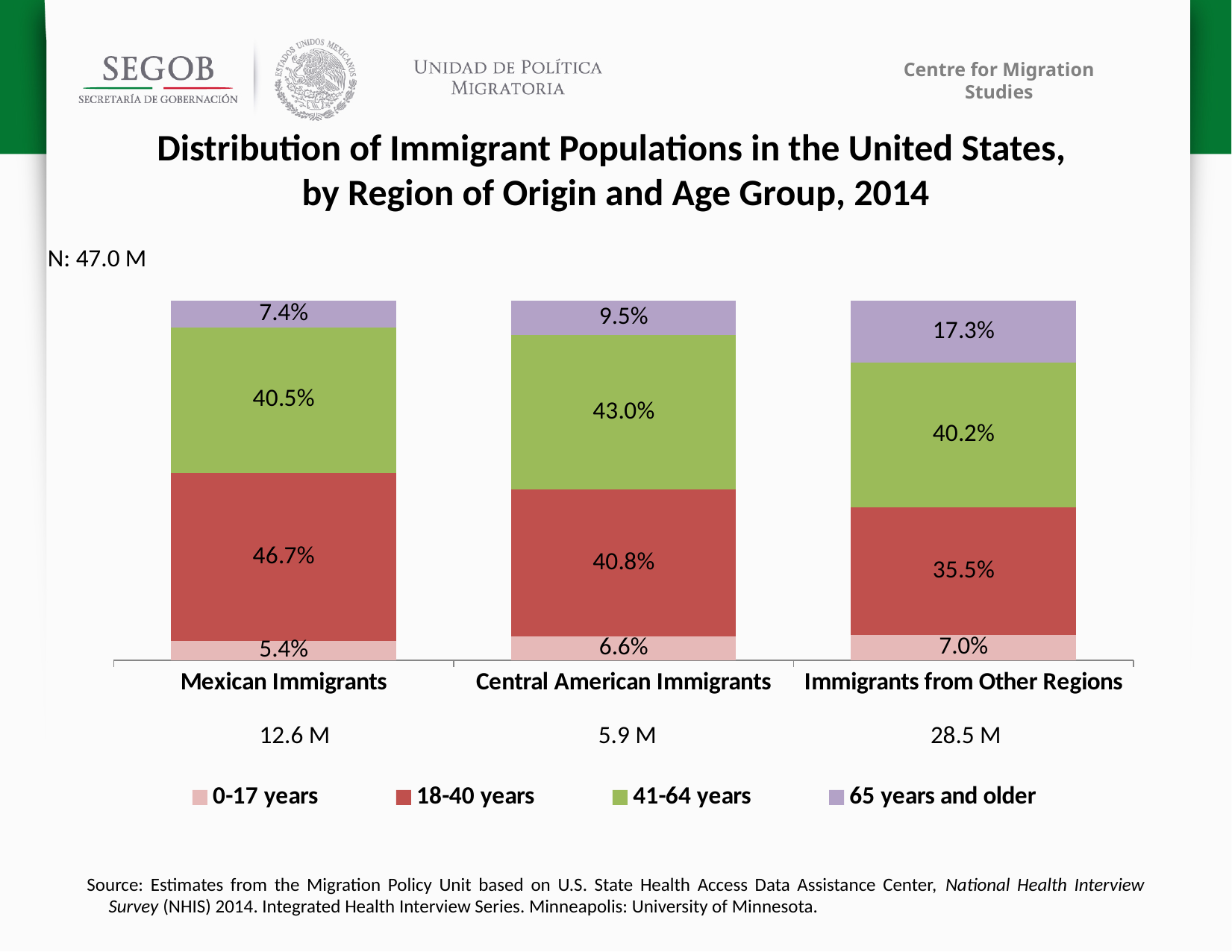
How many regions of origin are shown on the x axis? 3 Which region of origin has the highest share of immigrants aged 65 years and older? Immigrants from Other Regions What percentage of Mexican immigrants are aged 18-40 years? 46.7% What percentage of Central American immigrants are aged 41-64 years? 43.0% How many percentage points higher is the 18-40 years share for Mexican Immigrants than for Immigrants from Other Regions? 11.2 Which region of origin has the lowest share of immigrants aged 0-17 years? Mexican Immigrants What type of chart is shown on the slide? Stacked bar chart Is the 41-64 years share larger for Mexican Immigrants or for Central American Immigrants? Central American Immigrants How many age groups does the legend list? 4 What is the 0-17 years share for Central American Immigrants? 6.6% What is the difference in the 65 years and older share between Immigrants from Other Regions and Mexican Immigrants? 9.9 percentage points What share of Immigrants from Other Regions are 65 years and older? 17.3%